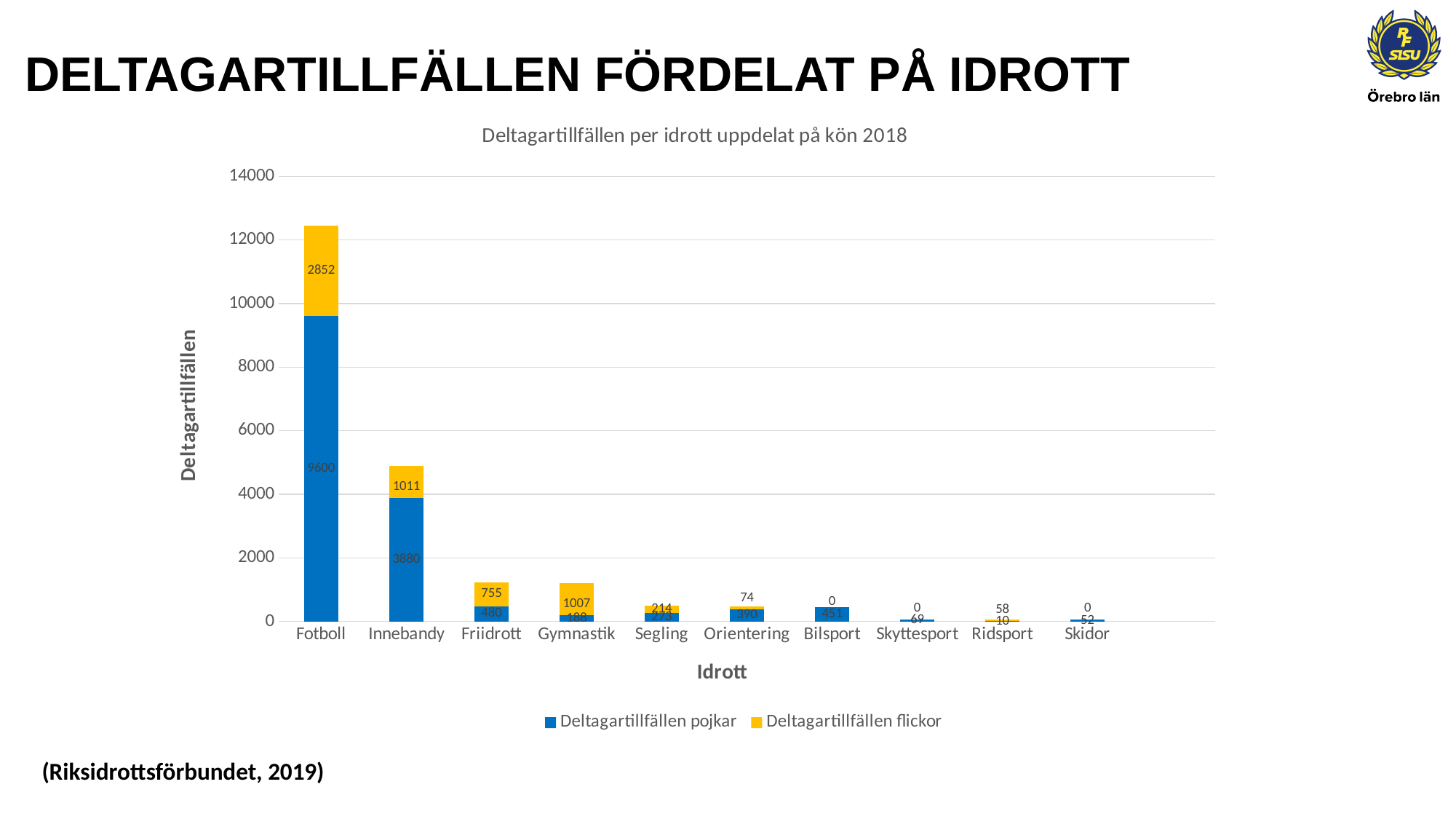
What is the value for Deltagartillfällen flickor for Bilsport? 0 What is the total of the stacked bar for Fotboll? 12452 What is the value for Deltagartillfällen pojkar for Innebandy? 3880 Which sport has the highest total number of deltagartillfällen? Fotboll What is the total of the stacked bar for Innebandy? 4891 What is the difference between Deltagartillfällen pojkar and Deltagartillfällen flickor for Fotboll? 6748 How many sports are shown on the x axis? 10 For Friidrott, which is larger: Deltagartillfällen pojkar or Deltagartillfällen flickor? Deltagartillfällen flickor What is the value for Deltagartillfällen pojkar for Fotboll? 9600 What is the value for Deltagartillfällen flickor for Fotboll? 2852 What is the value for Deltagartillfällen flickor for Gymnastik? 1007 How many series does the legend list? 2